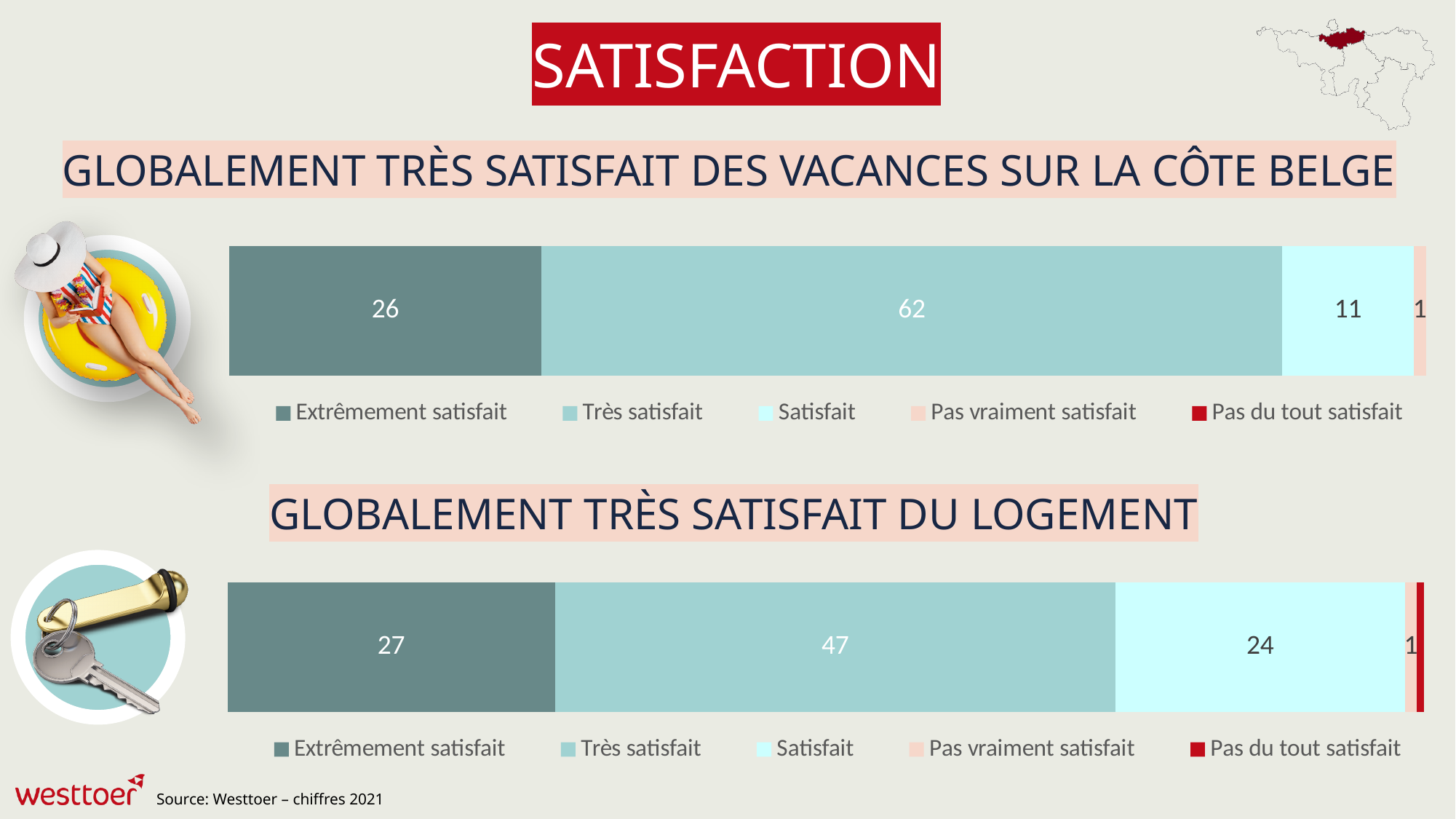
In the chart titled 'Globalement très satisfait des vacances sur la côte belge', what is the difference between 'Très satisfait' and 'Extrêmement satisfait'? 36 In the chart titled 'Globalement très satisfait des vacances sur la côte belge', what is the value for 'Très satisfait'? 62 In the chart titled 'Globalement très satisfait du logement', what is the value for 'Satisfait'? 24 What kind of chart is the chart titled 'Globalement très satisfait des vacances sur la côte belge'? Stacked bar chart In the chart titled 'Globalement très satisfait des vacances sur la côte belge', what is the value for 'Satisfait'? 11 In the chart titled 'Globalement très satisfait du logement', what is the value for 'Très satisfait'? 47 In the chart titled 'Globalement très satisfait du logement', which is larger: 'Très satisfait' or 'Satisfait'? Très satisfait In the chart titled 'Globalement très satisfait du logement', which category has the largest value? Très satisfait In the chart titled 'Globalement très satisfait des vacances sur la côte belge', which category has the largest value? Très satisfait In the chart titled 'Globalement très satisfait des vacances sur la côte belge', what is the value for 'Extrêmement satisfait'? 26 How many series does the legend of the chart titled 'Globalement très satisfait du logement' list? 5 In the chart titled 'Globalement très satisfait du logement', what is the value for 'Extrêmement satisfait'? 27